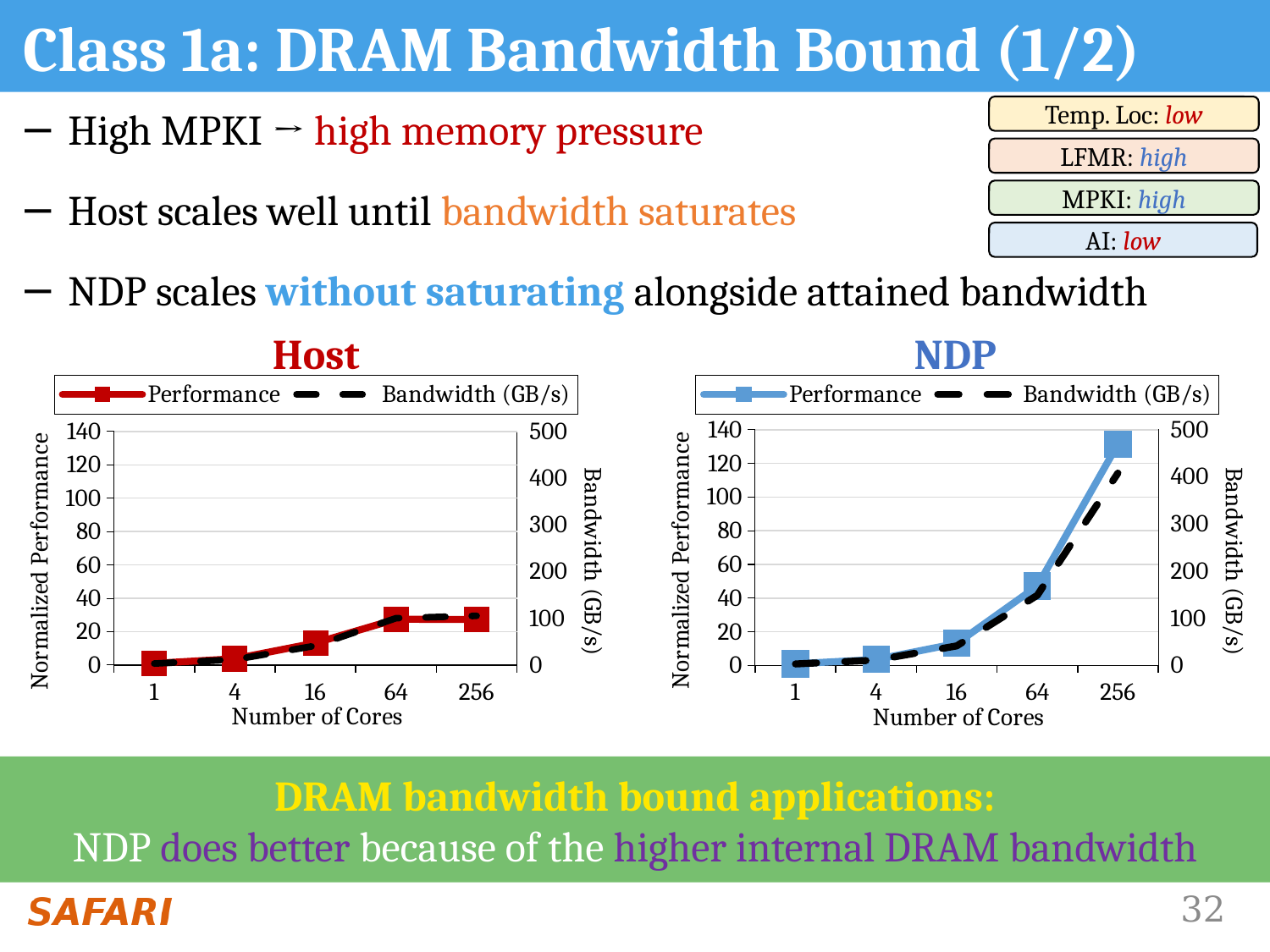
In the Host chart, is the Performance value at 64 cores greater or less than 20? greater How many series does the legend of the NDP chart list? 2 In the NDP chart, is the Bandwidth (GB/s) value at 64 cores greater or less than 100? greater In the Host chart, is the Performance value at 256 cores greater or less than 40? less What is the label of the right-hand y axis on the NDP chart? Bandwidth (GB/s) What kind of chart is the Host chart? line chart What is the label of the x axis on the Host chart? Number of Cores How many core counts are plotted along the x axis of the Host chart? 5 In the NDP chart, at which number of cores is Performance highest? 256 In the NDP chart, does Performance rise or fall as the number of cores increases? rise In the NDP chart, which is larger: Performance at 64 cores or Performance at 16 cores? 64 cores